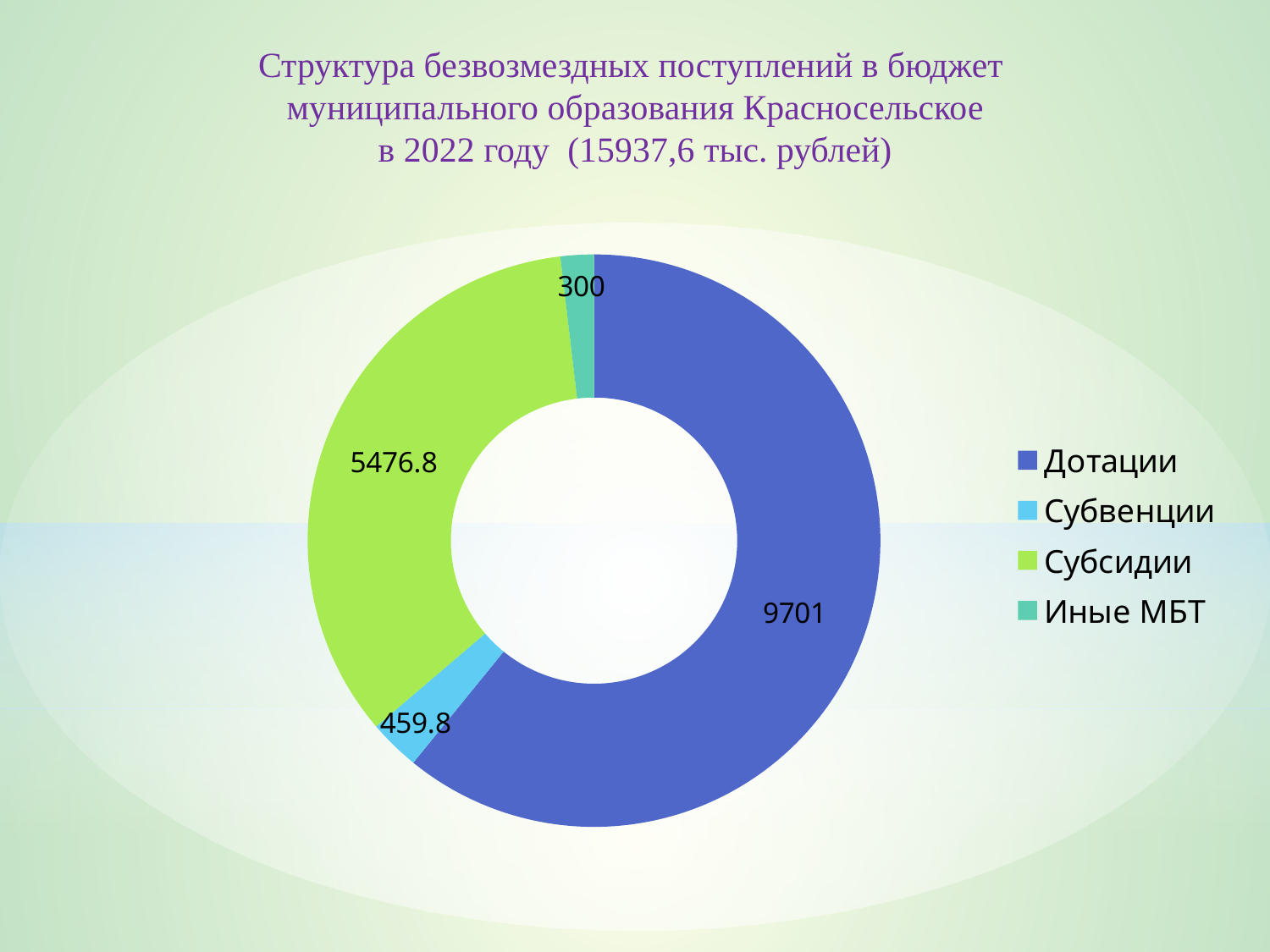
What kind of chart is shown on the slide? doughnut chart What is the value for Иные МБТ? 300 Which colour represents Субсидии in the legend? green How many categories are shown in the chart? 4 What is the value for Субвенции? 459.8 What is the difference between the values for Дотации and Субсидии? 4224.2 Which is larger, the value for Субсидии or the value for Субвенции? Субсидии Which category has the smallest value? Иные МБТ Which category has the largest value? Дотации What is the difference between the values for Субвенции and Иные МБТ? 159.8 What is the value for Субсидии? 5476.8 What is the value for Дотации? 9701